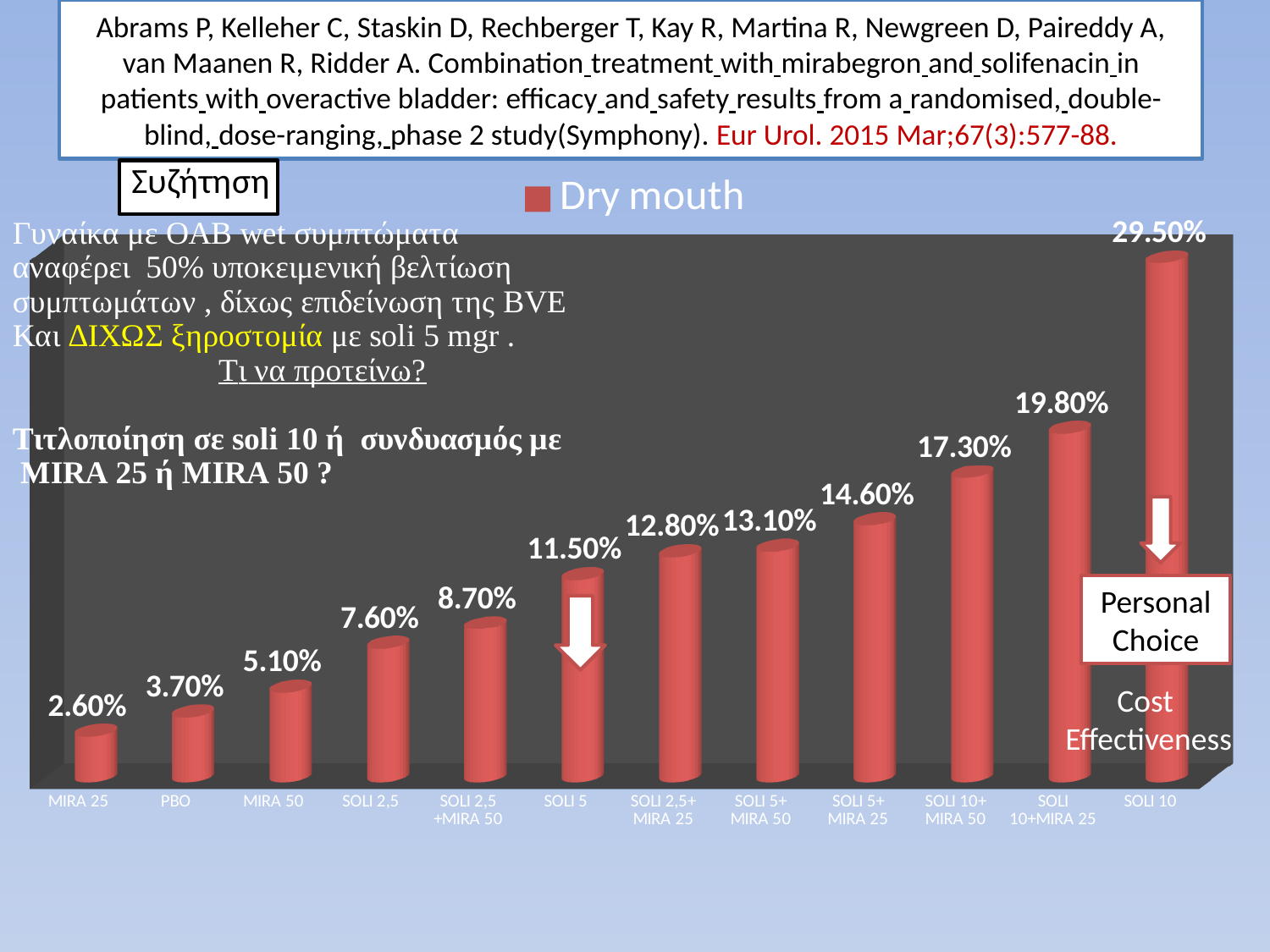
Which has a higher dry mouth rate, MIRA 50 or SOLI 2,5? SOLI 2,5 What is the difference in dry mouth rate between SOLI 10 and SOLI 10+MIRA 25? 9.70% How many categories are shown on the x axis of the chart? 12 Which category has the lowest dry mouth rate? MIRA 25 What is the dry mouth rate for SOLI 5? 11.50% What type of chart is shown on the slide? Bar chart What is the dry mouth rate for PBO? 3.70% What is the dry mouth rate for SOLI 10+MIRA 25? 19.80% What series name is shown in the chart legend? Dry mouth Which category has the highest dry mouth rate? SOLI 10 What is the difference in dry mouth rate between SOLI 5 and PBO? 7.80% What is the dry mouth rate for SOLI 10? 29.50%